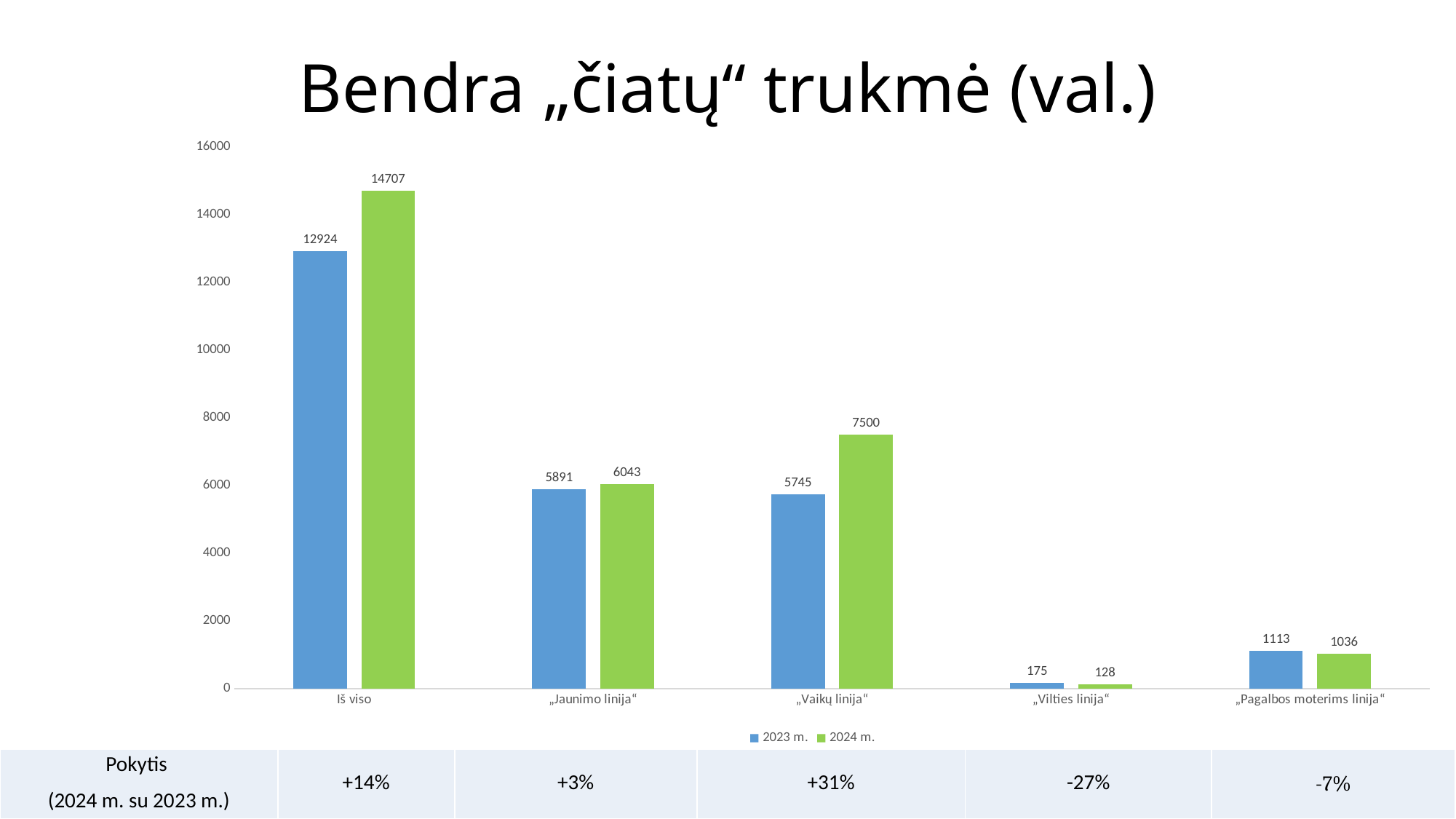
Which is larger for „Pagalbos moterims linija“: the 2023 m. value or the 2024 m. value? 2023 m. What is the value for „Jaunimo linija“ in the 2023 m. series? 5891 What is the difference between the 2024 m. and 2023 m. values for „Vaikų linija“? 1755 What is the value for „Vilties linija“ in the 2024 m. series? 128 What is the title of the chart? Bendra „čiatų“ trukmė (val.) What is the value for „Vaikų linija“ in the 2024 m. series? 7500 How many series does the legend list? 2 Which category has the lowest value in the 2023 m. series? „Vilties linija“ Which category has the highest value in the 2024 m. series? Iš viso What is the difference between the 2024 m. and 2023 m. values for Iš viso? 1783 How many categories are shown on the x axis? 5 What kind of chart is shown on the slide? Bar chart